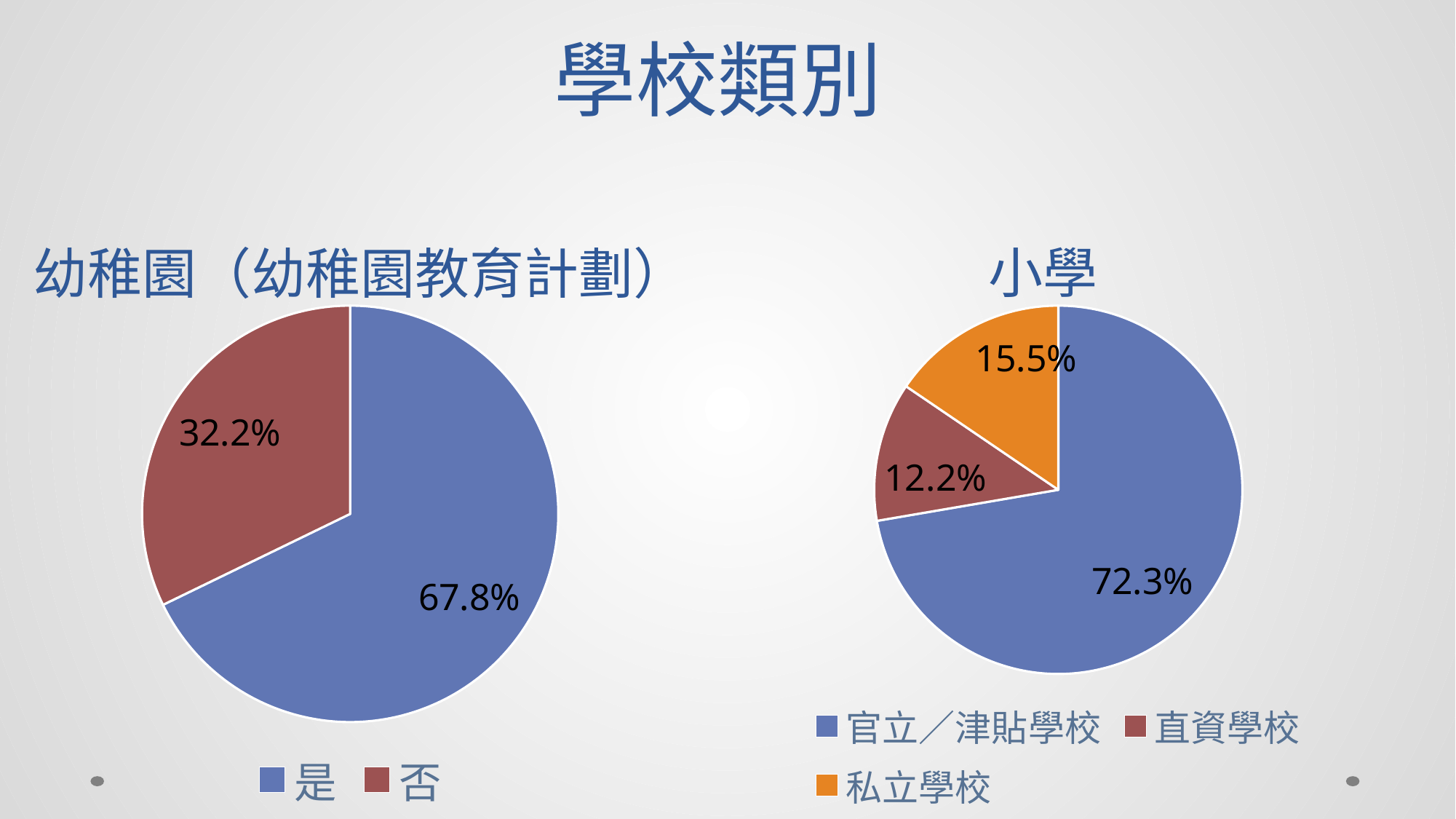
In the 小學 chart, which category has the smallest slice? 直資學校 In the 小學 chart, what is the value for 私立學校? 15.5% In the 小學 chart, what is the value for 官立／津貼學校? 72.3% What kind of chart is the 幼稚園（幼稚園教育計劃） chart? Pie chart In the 小學 chart, which is larger, 私立學校 or 直資學校? 私立學校 In the 小學 chart, what is the difference between 官立／津貼學校 and 私立學校? 56.8% In the 幼稚園（幼稚園教育計劃） chart, what share of the pie is 是? 67.8% How many categories does the 小學 chart show? 3 In the 小學 chart, what is the value for 直資學校? 12.2% In the 小學 chart, which category has the largest slice? 官立／津貼學校 In the 幼稚園（幼稚園教育計劃） chart, what is the difference between 是 and 否? 35.6% In the 幼稚園（幼稚園教育計劃） chart, what share of the pie is 否? 32.2%